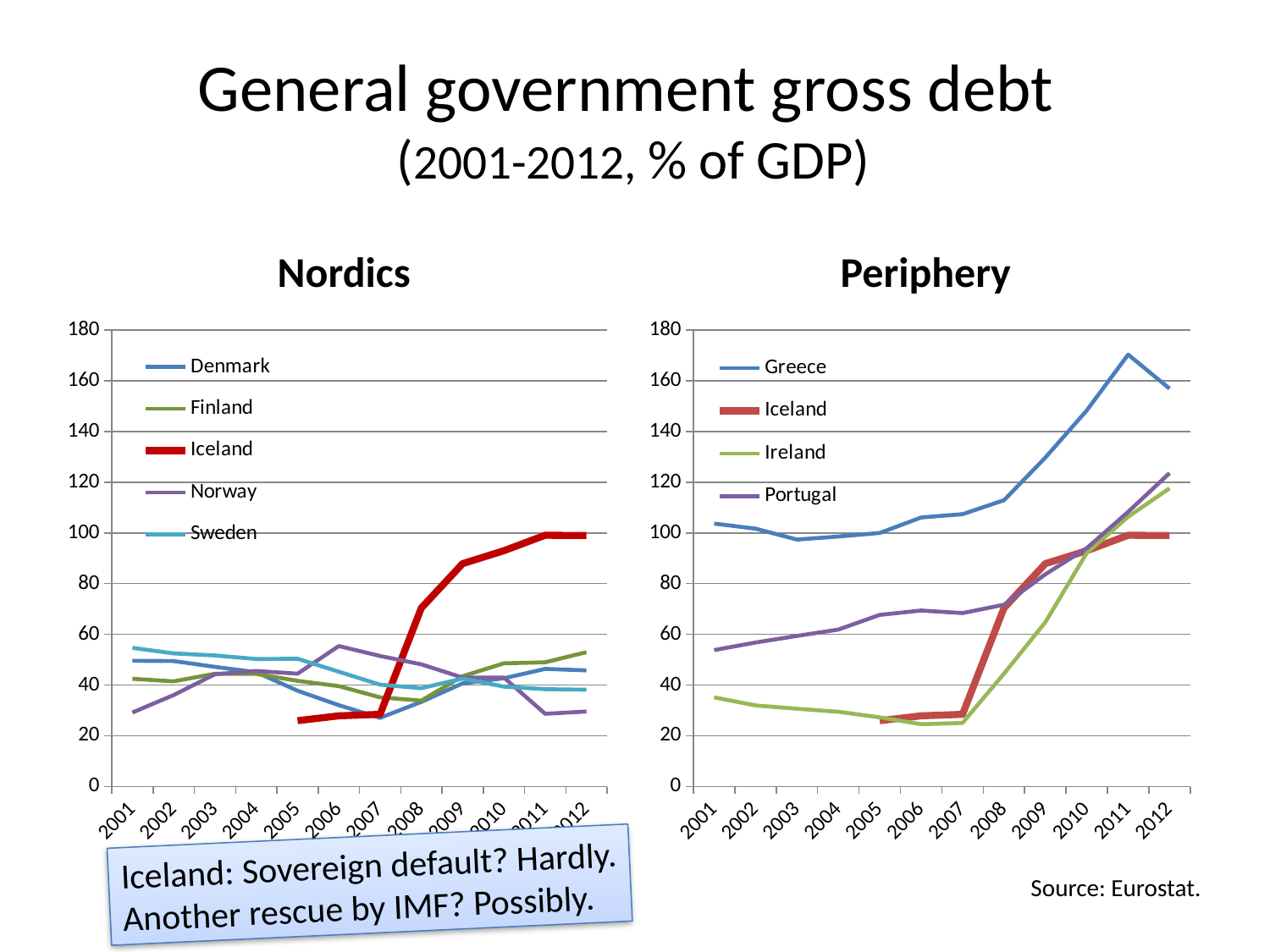
In the Nordics chart, is the value for Iceland in 2005 greater or less than 40? less How many series does the legend of the Periphery chart list? 4 In the Nordics chart, which country has the lowest value in 2012? Norway In the Periphery chart, is the value for Portugal in 2012 greater or less than 100? greater In the Periphery chart, is the value for Greece in 2011 greater or less than 160? greater How many years are shown on the x axis of the Periphery chart? 12 How many series does the legend of the Nordics chart list? 5 In the Nordics chart, which is larger in 2012, Denmark or Norway? Denmark In the Periphery chart, does the value for Greece rise or fall from 2001 to 2011? rise What kind of chart is the Nordics chart? line chart In the Nordics chart, which country has the highest value in 2012? Iceland In the Periphery chart, which country has the highest value in 2012? Greece